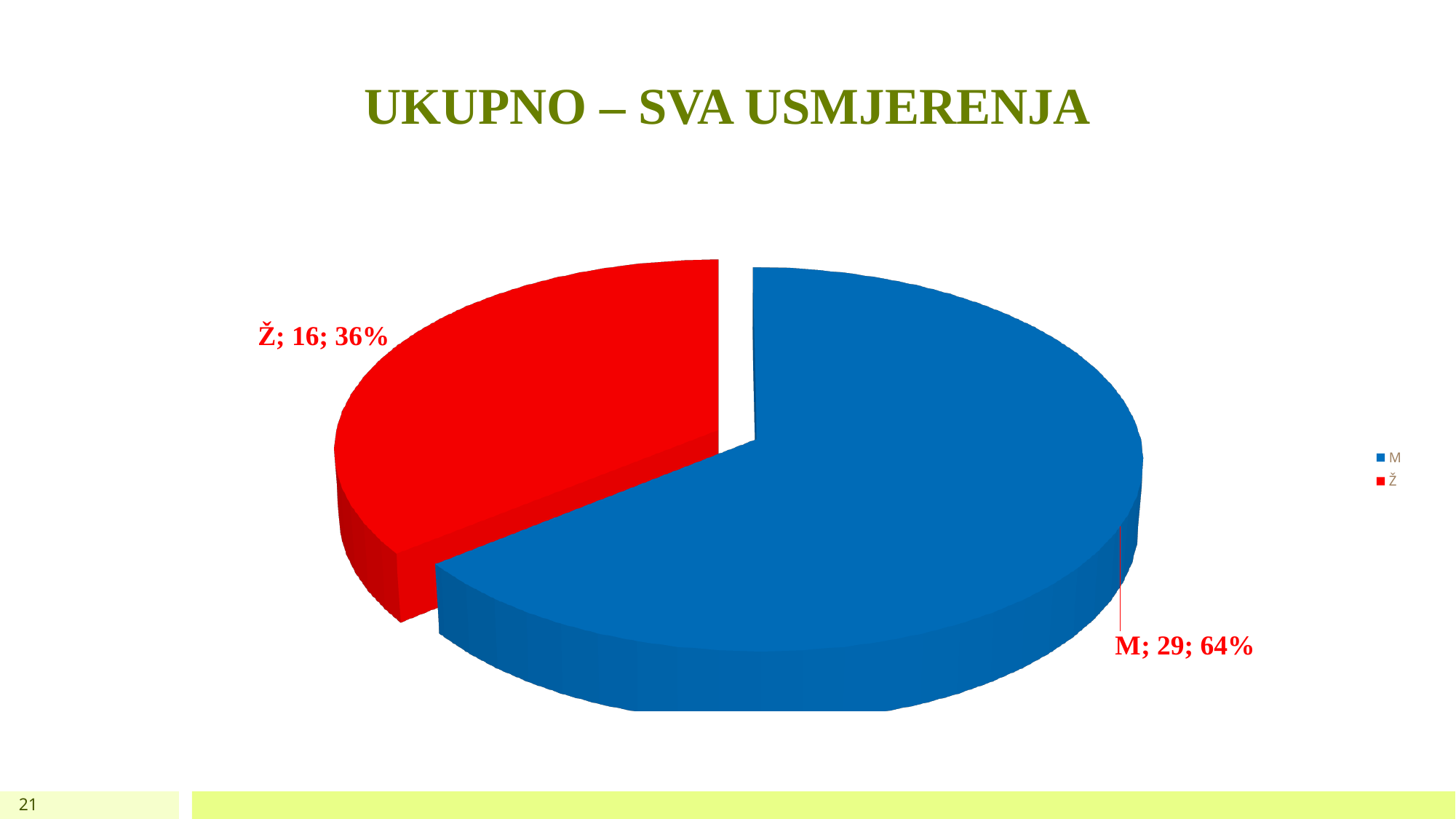
What is the title of the chart? UKUPNO – SVA USMJERENJA How many slices does the pie chart have? 2 What share of the pie does Ž represent? 36% What is the value for M? 29 What kind of chart is shown on the slide? pie chart What is the difference between the values for M and Ž? 13 Which category has the largest slice? M Which category has the smallest slice? Ž What is the value for Ž? 16 What share of the pie does M represent? 64% What is the total of the values for M and Ž? 45 Which is larger, the value for M or the value for Ž? M